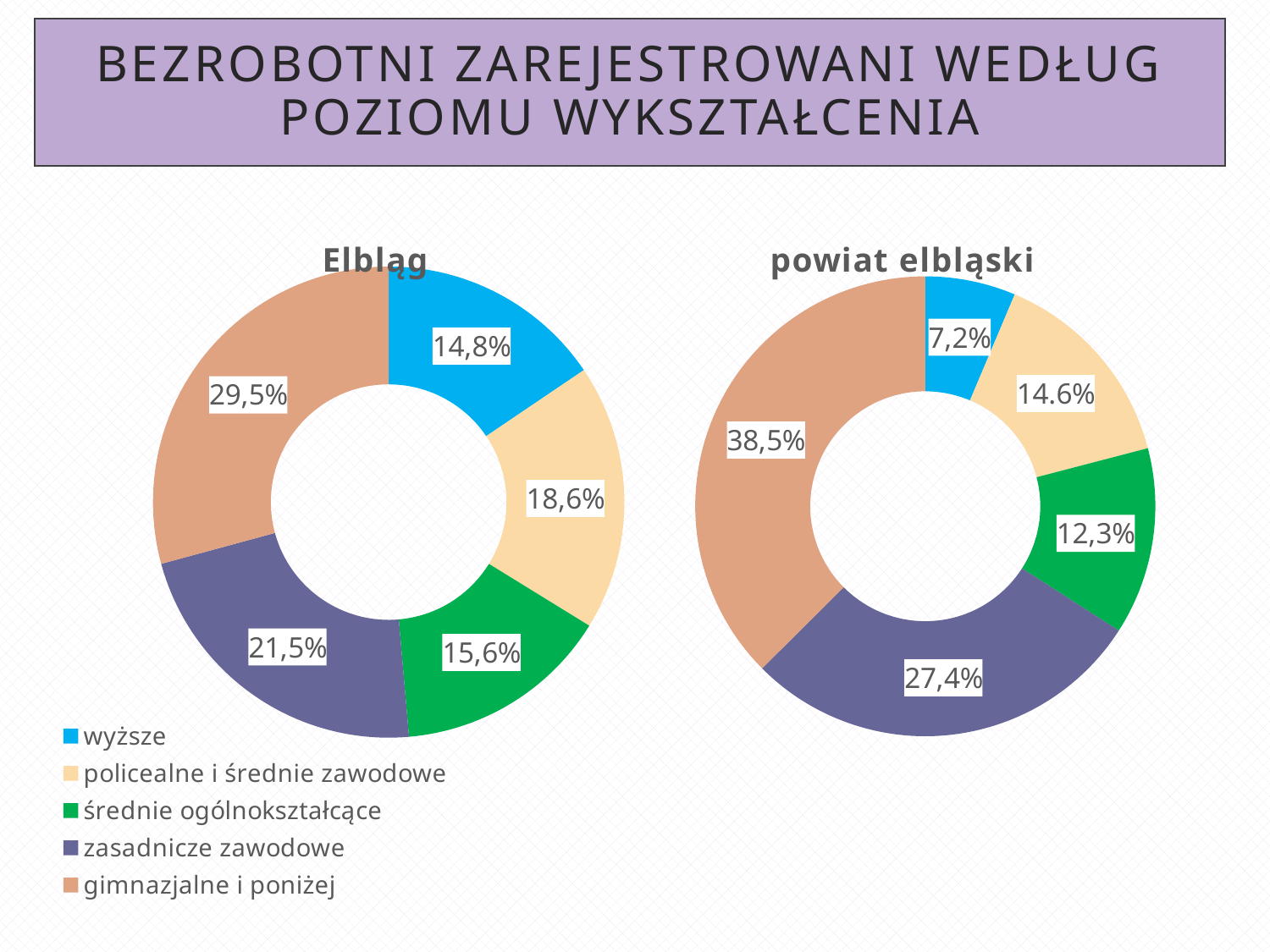
In the Elbląg chart, which category has the smallest share? wyższe In the powiat elbląski chart, what is the difference between gimnazjalne i poniżej and zasadnicze zawodowe? 11,1 percentage points In the powiat elbląski chart, what is the value for gimnazjalne i poniżej? 38,5% How many categories does each chart show? 5 In the Elbląg chart, what is the value for wyższe? 14,8% In the Elbląg chart, what is the difference between zasadnicze zawodowe and średnie ogólnokształcące? 5,9 percentage points Which chart shows a larger share for wyższe, Elbląg or powiat elbląski? Elbląg In the powiat elbląski chart, what is the value for policealne i średnie zawodowe? 14.6% What kind of chart is used on this slide? pie chart (doughnut) Which colour represents zasadnicze zawodowe in the legend? purple In the powiat elbląski chart, which category has the smallest share? wyższe In the Elbląg chart, which category has the largest share? gimnazjalne i poniżej